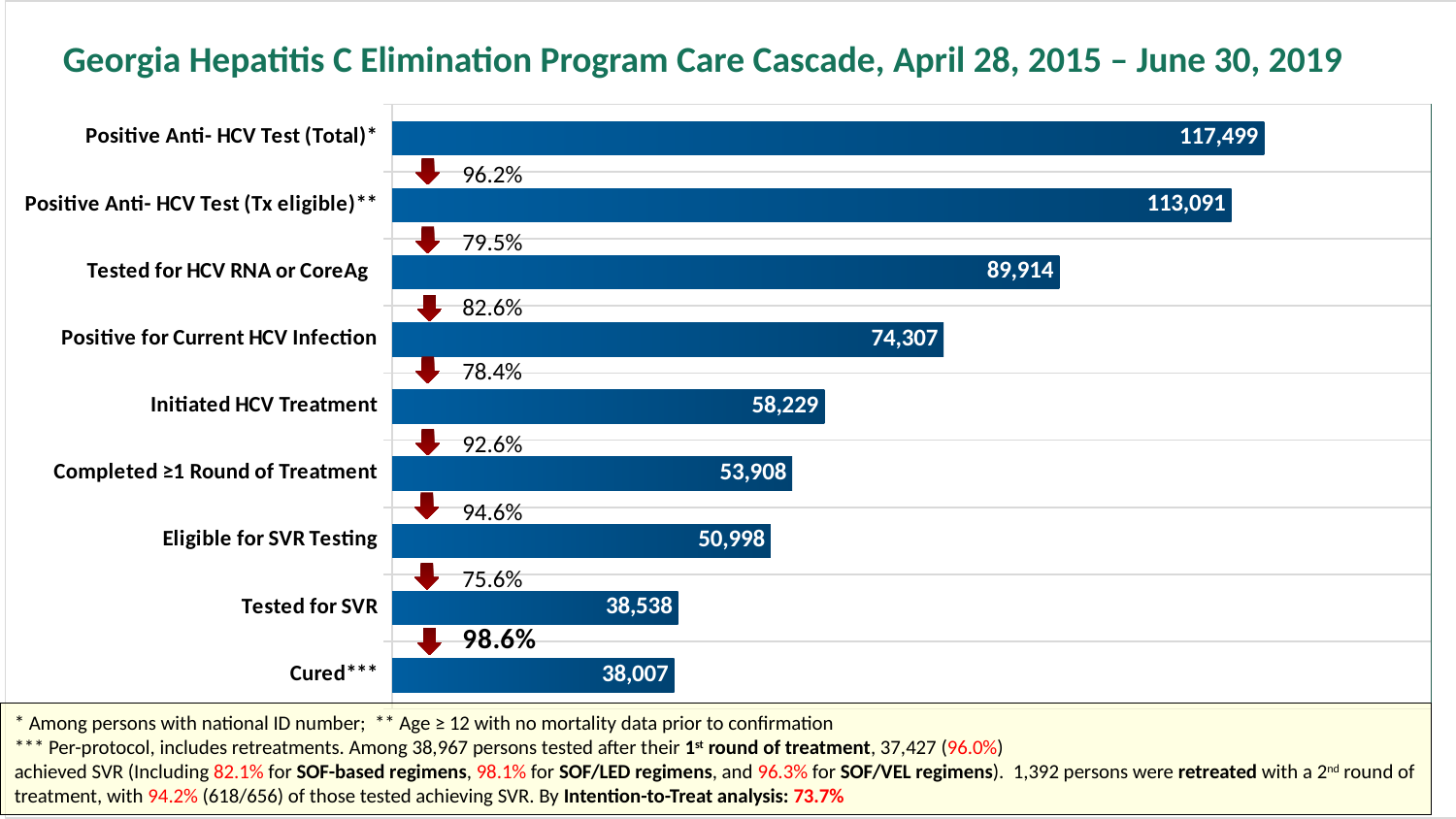
What is the value for Initiated HCV Treatment? 58,229 What is the value for Cured? 38,007 What is the value for Tested for HCV RNA or CoreAg? 89,914 What type of chart is shown on the slide? bar chart What percentage is shown between Tested for SVR and Cured? 98.6% Which category has the lowest value? Cured Which category has the highest value? Positive Anti-HCV Test (Total) How many categories (bars) does the chart show? 9 What is the value for Positive Anti-HCV Test (Total)? 117,499 Which is larger, Completed ≥1 Round of Treatment or Eligible for SVR Testing? Completed ≥1 Round of Treatment What is the difference between Positive Anti-HCV Test (Total) and Positive Anti-HCV Test (Tx eligible)? 4,408 What is the difference between Tested for SVR and Cured? 531